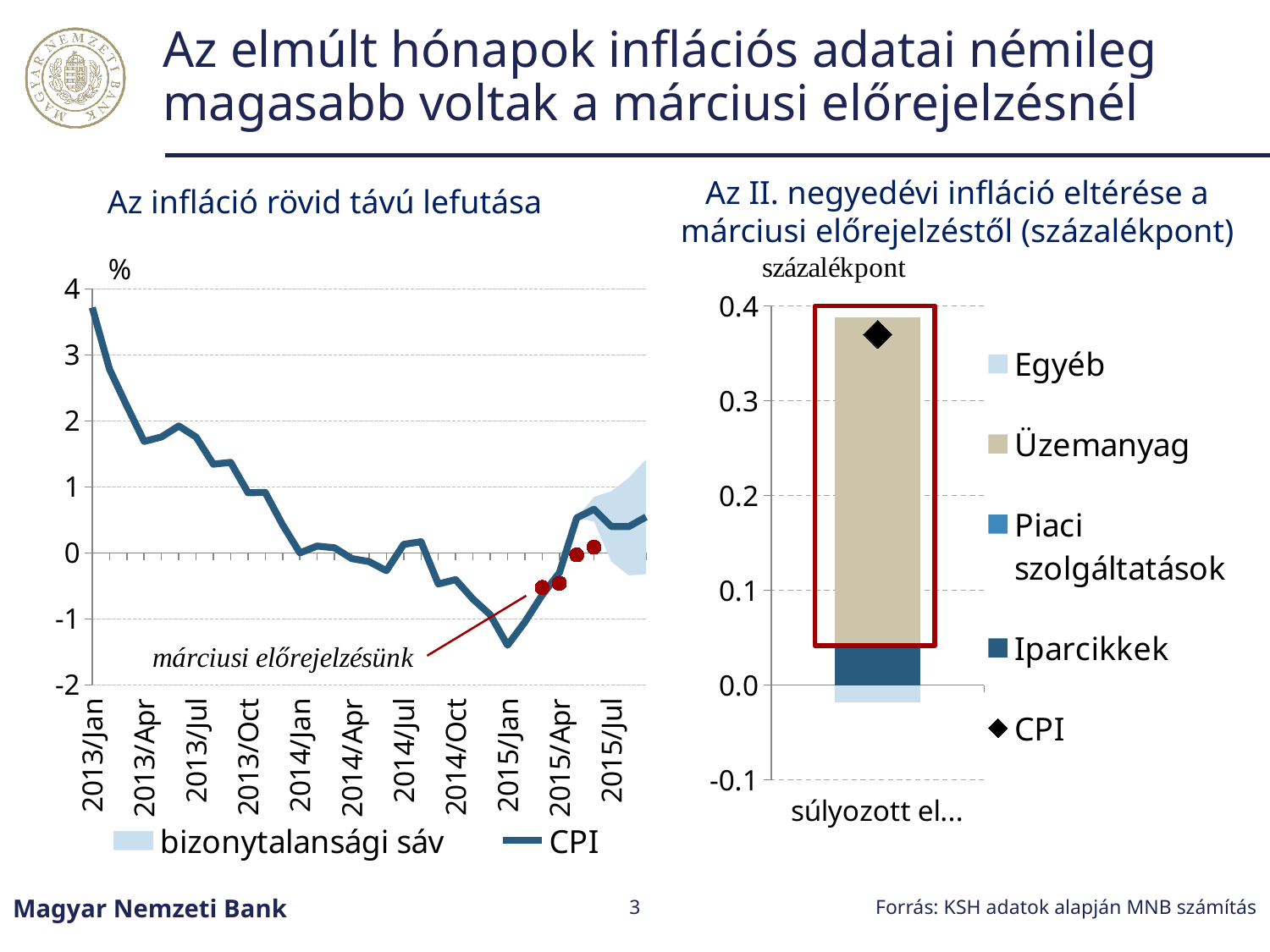
In the right chart, which legend category forms the largest segment of the bar? Üzemanyag In the right chart, how many entries does the legend list? 5 What unit is shown on the y axis of the left chart? % In the left chart, how many entries does the legend list? 2 In the left chart, does the CPI line rise or fall from 2013/Jan to 2015/Jan? fall In the right chart, is the CPI marker greater or less than 0.3? greater What kind of chart is the left chart, 'Az infláció rövid távú lefutása'? line chart In the left chart, at which x-axis label is the CPI line at its lowest? 2015/Jan What kind of chart is the right chart, 'Az II. negyedévi infláció eltérése a márciusi előrejelzéstől'? bar chart In the left chart, is the CPI value for 2013/Jan greater or less than 3? greater In the left chart, is the CPI value for 2015/Jan greater or less than -1? less In the left chart, at which x-axis label is the CPI line at its highest? 2013/Jan